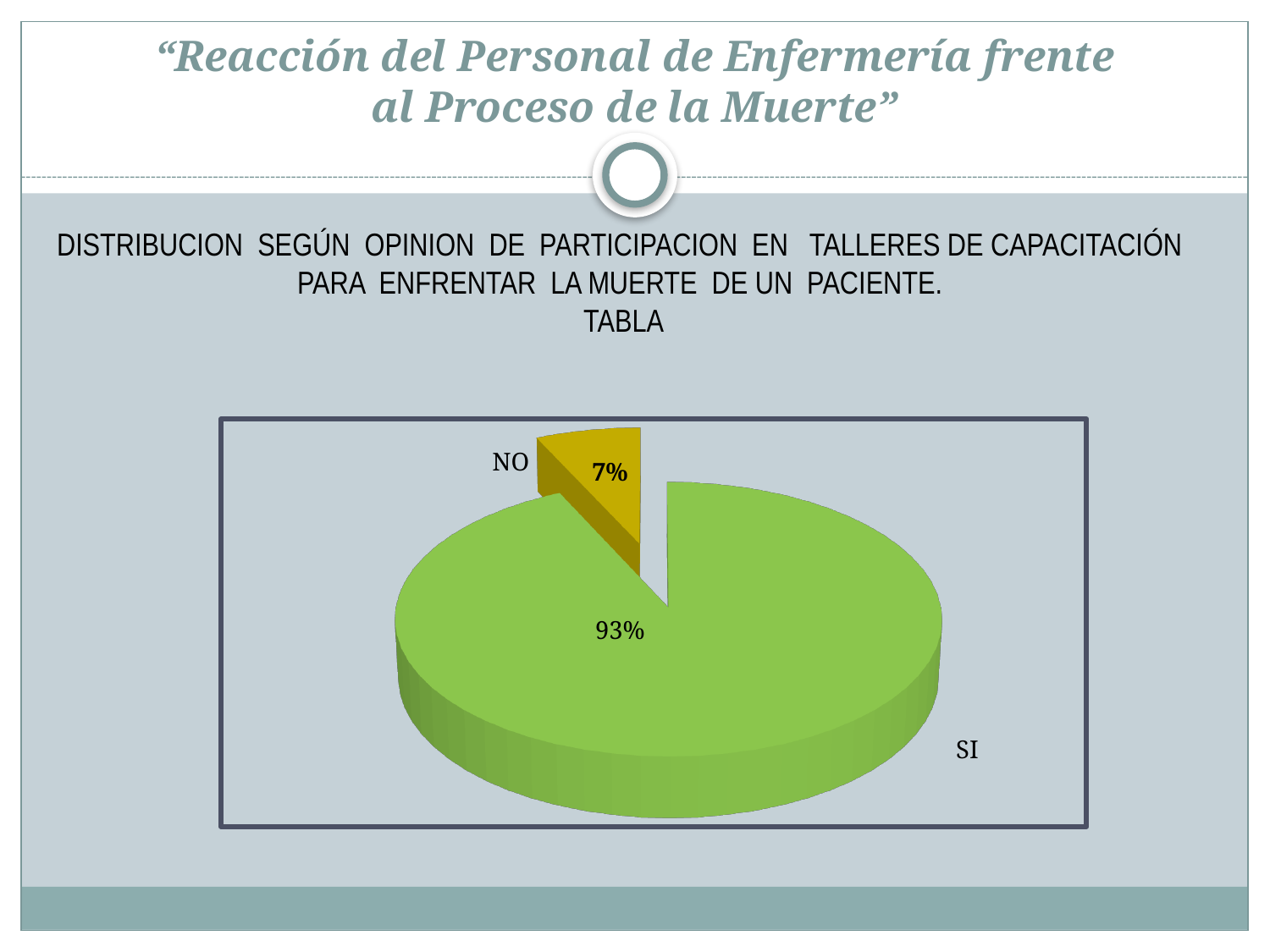
Which category has the smallest share of the pie? NO What percentage is shown for the NO slice? 7% Which category has the largest share of the pie? SI What colour is the SI slice of the pie chart? green What kind of chart is shown on the slide? pie chart How many slices does the pie chart have? 2 What is the difference in percentage points between the SI and NO slices? 86 What colour is the NO slice of the pie chart? yellow What percentage is shown for the SI slice? 93% Which is larger, the SI slice or the NO slice? SI What share of the pie does the NO slice represent? 7%